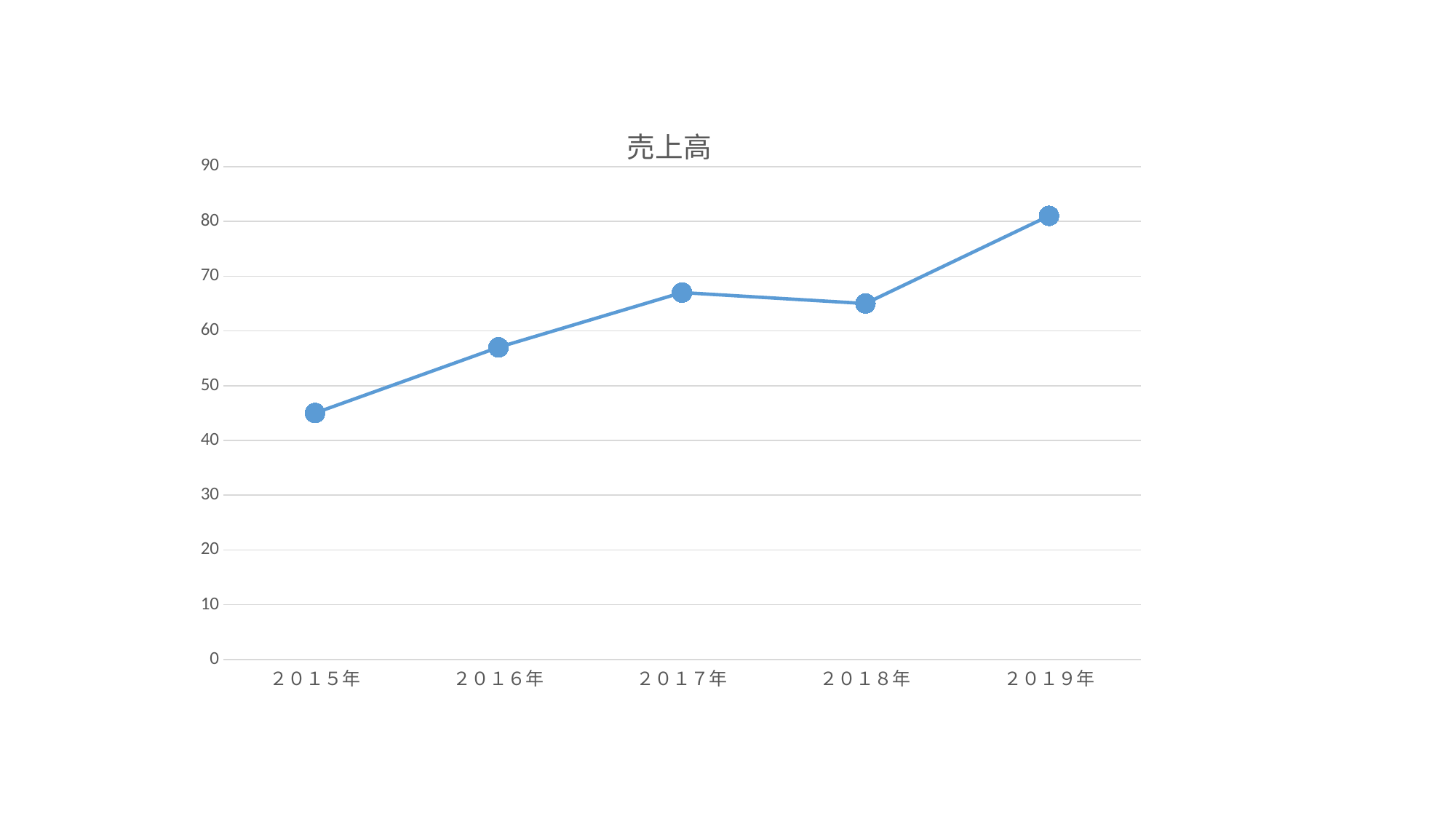
Which year has the highest value? 2019年 Is the value for 2019年 greater or less than 70? greater Which is larger, the value for 2016年 or the value for 2017年? 2017年 Is the value for 2016年 greater or less than 60? less Do the values generally rise or fall from 2015年 to 2019年? rise Which year has the lowest value? 2015年 Is the value for 2017年 greater or less than 60? greater What is the title of the chart? 売上高 What kind of chart is shown on the slide? line chart How many data points are plotted on the line? 5